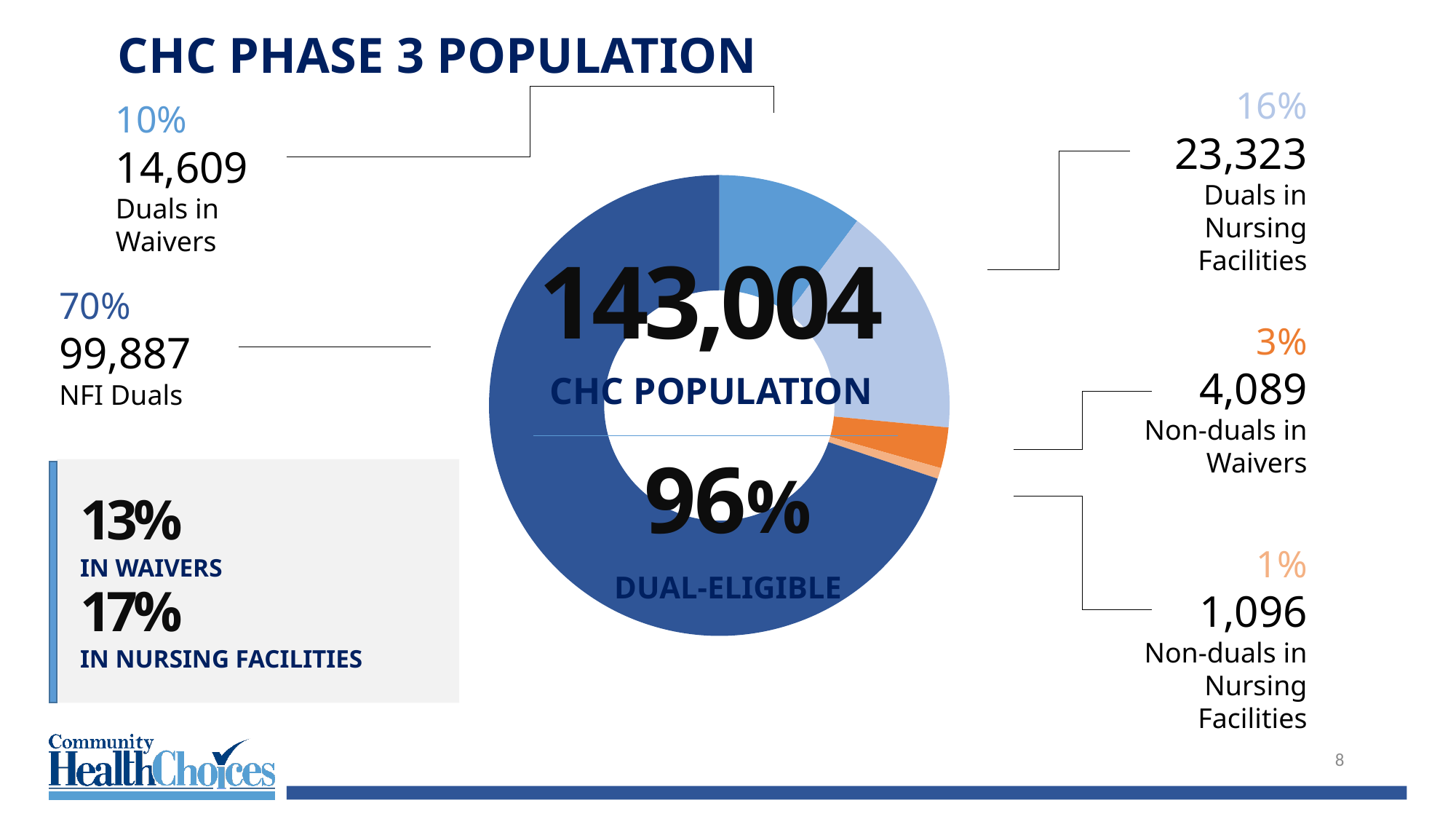
What is the value for NFI Duals? 99,887 What is the difference between Duals in Nursing Facilities and Duals in Waivers? 8,714 How many categories are shown in the chart? 5 What is the value for Duals in Nursing Facilities? 23,323 What percentage share does Duals in Waivers represent? 10% Which category has the largest share of the CHC population? NFI Duals What is the value for Non-duals in Waivers? 4,089 What kind of chart is shown on the slide? Donut (pie) chart Which category has the smallest share of the CHC population? Non-duals in Nursing Facilities Which is larger, Non-duals in Waivers or Non-duals in Nursing Facilities? Non-duals in Waivers What total CHC population is shown in the centre of the chart? 143,004 What percentage share does Non-duals in Nursing Facilities represent? 1%